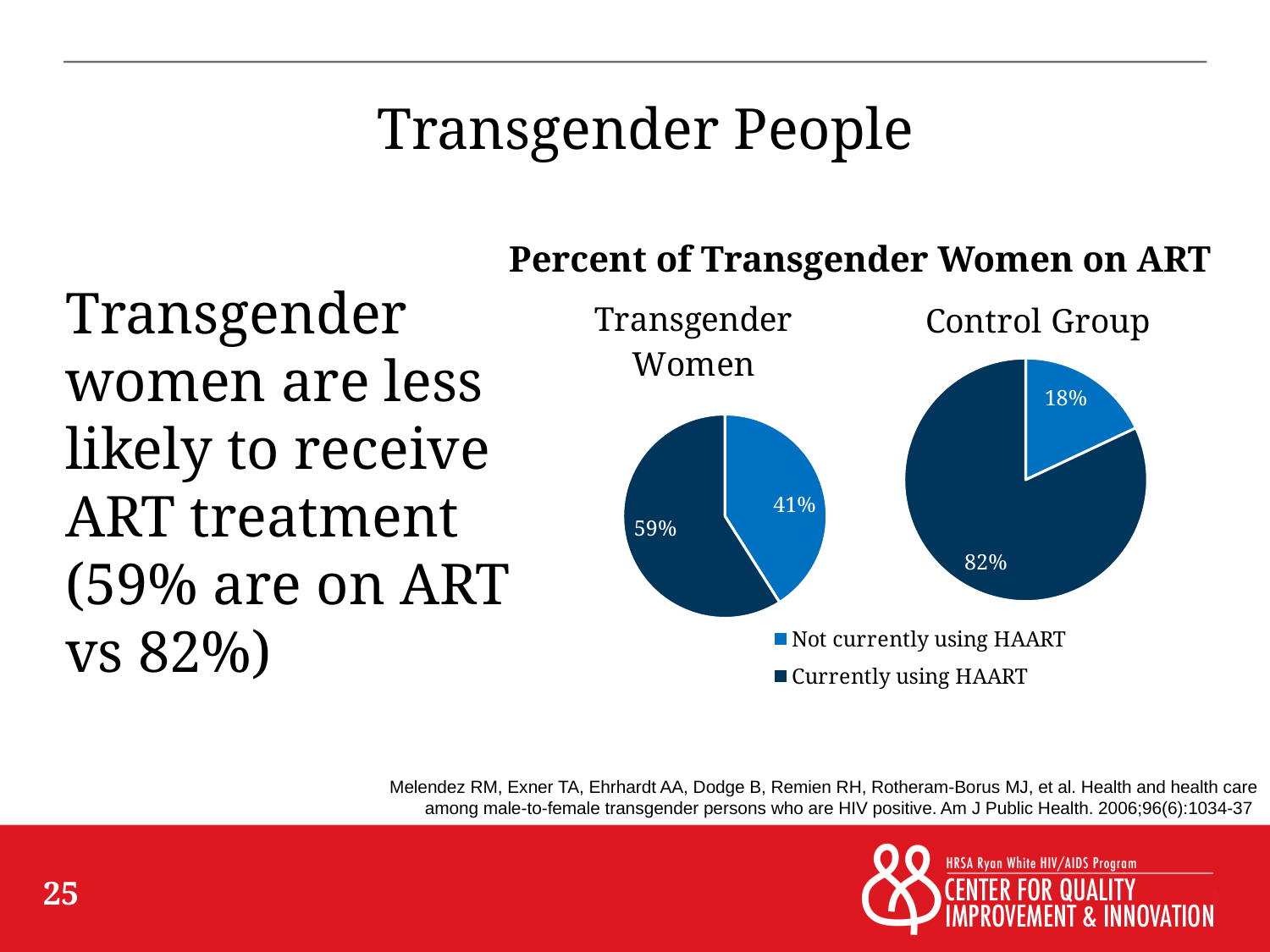
What type of chart is used to show the percent of transgender women on ART? Pie chart In the Transgender Women pie chart, which slice is the smallest? Not currently using HAART In the Transgender Women pie chart, what percentage are not currently using HAART? 41% How many slices does the Transgender Women pie chart have? 2 In the Transgender Women pie chart, what percentage are currently using HAART? 59% In the Control Group pie chart, which slice is the largest? Currently using HAART In the Control Group pie chart, what percentage are not currently using HAART? 18% What is the difference between the percentage currently using HAART in the Control Group chart and in the Transgender Women chart? 23% What is the overall title above the two pie charts? Percent of Transgender Women on ART Which is larger: the share not currently using HAART in the Transgender Women chart or in the Control Group chart? Transgender Women How many entries does the legend list? 2 In the Control Group pie chart, what percentage are currently using HAART? 82%